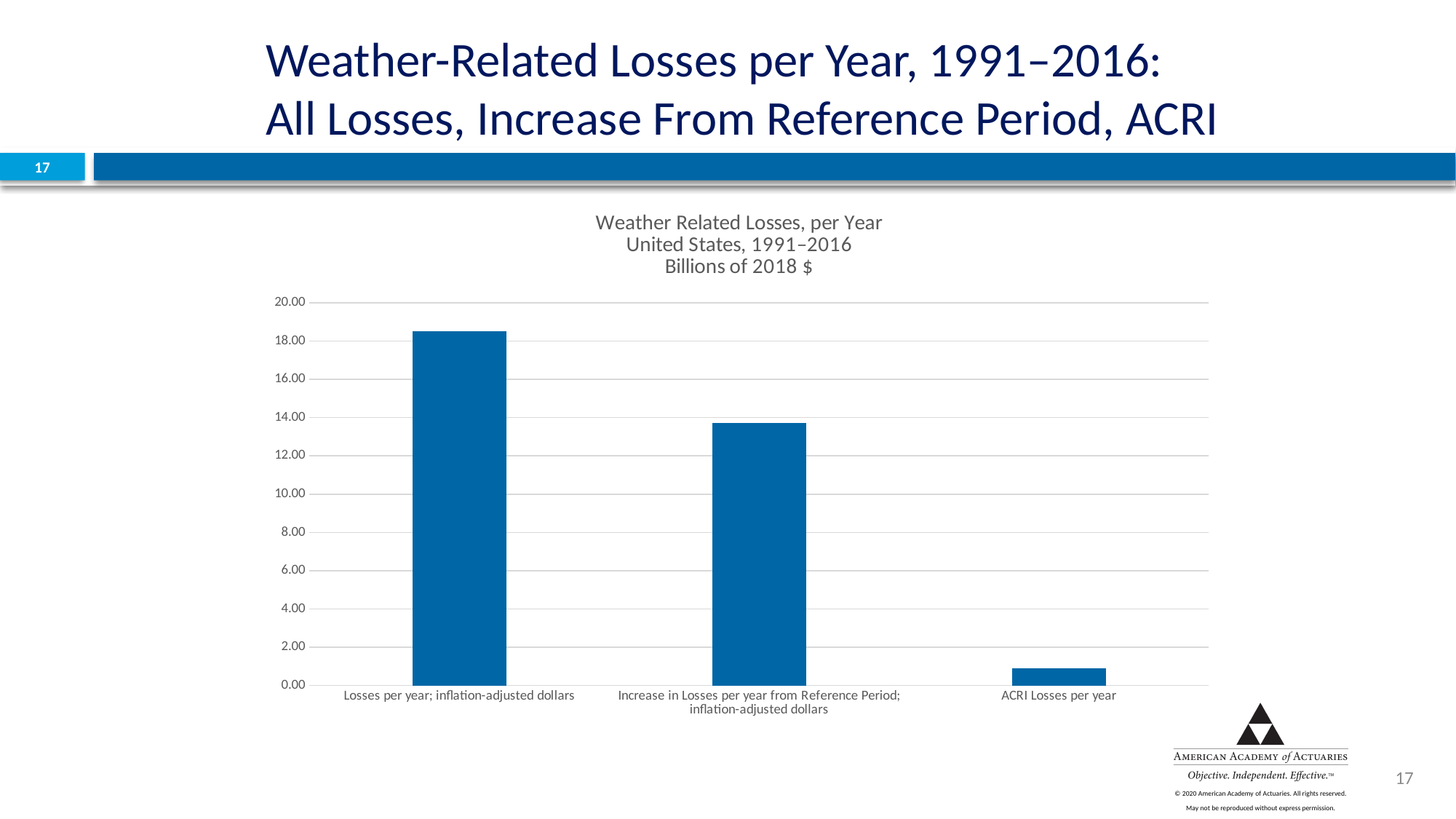
What is the highest value shown on the vertical axis? 20.00 In what units are the values on the chart expressed, according to the chart title? Billions of 2018 $ Do the bar values rise or fall from left to right across the chart? fall How many bars (categories) does the chart show? 3 What kind of chart is shown on the slide? bar chart Which is larger: the value for 'ACRI Losses per year' or the value for 'Increase in Losses per year from Reference Period; inflation-adjusted dollars'? Increase in Losses per year from Reference Period; inflation-adjusted dollars Which is larger: the value for 'Losses per year; inflation-adjusted dollars' or the value for 'Increase in Losses per year from Reference Period; inflation-adjusted dollars'? Losses per year; inflation-adjusted dollars Which category has the lowest value? ACRI Losses per year Is the value for 'Losses per year; inflation-adjusted dollars' greater or less than 18.00? greater Which category has the highest value? Losses per year; inflation-adjusted dollars Is the value for 'Increase in Losses per year from Reference Period; inflation-adjusted dollars' greater or less than 14.00? less Is the value for 'ACRI Losses per year' greater or less than 2.00? less